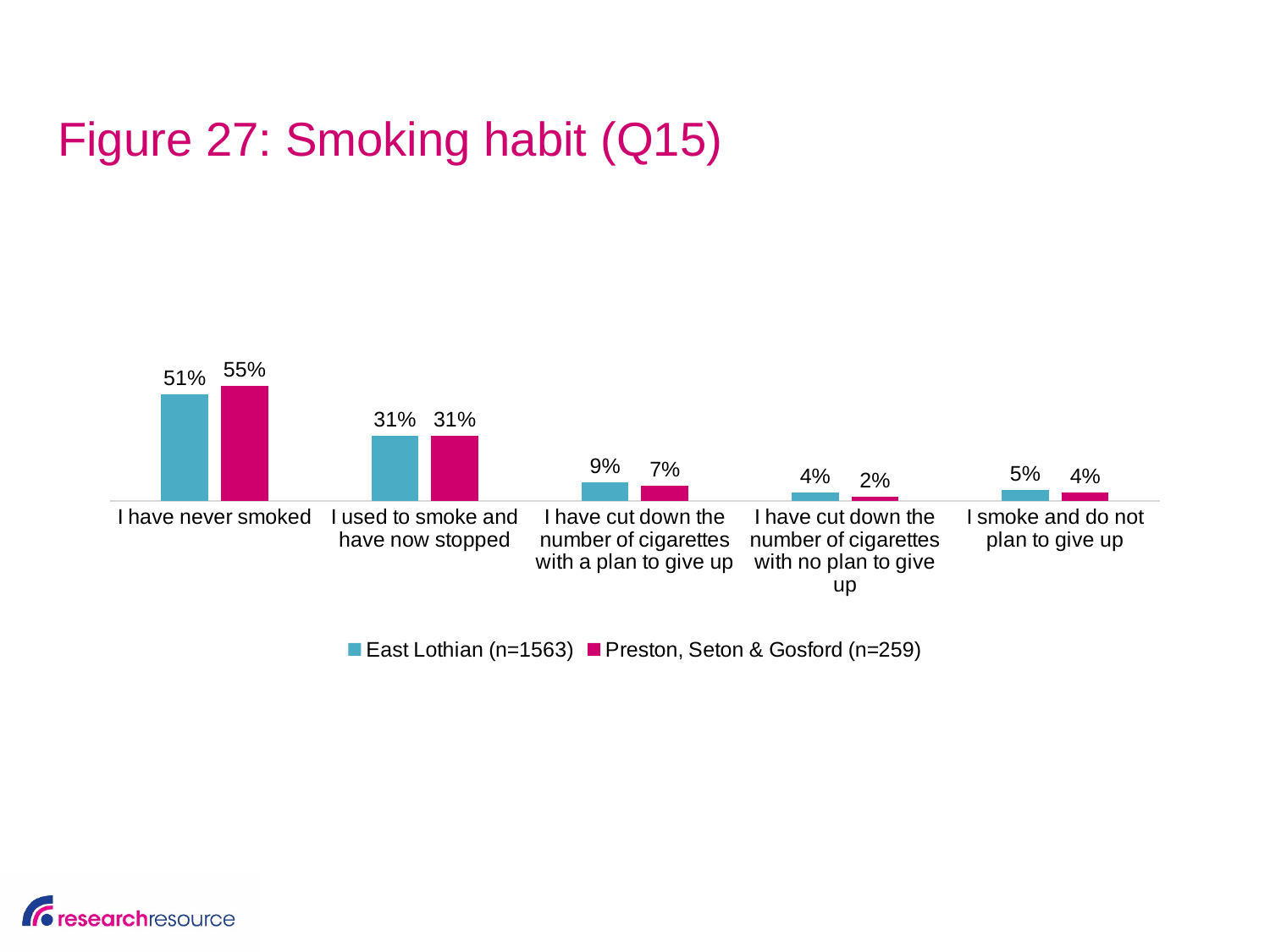
What kind of chart is shown on the slide? Bar chart What percentage of East Lothian respondents said 'I have never smoked'? 51% How many categories are shown on the x axis? 5 What is the value for East Lothian for 'I smoke and do not plan to give up'? 5% Which category has the lowest value for Preston, Seton & Gosford? I have cut down the number of cigarettes with no plan to give up How many series does the legend list? 2 Which category has the highest value for East Lothian? I have never smoked What is the sample size (n) for the Preston, Seton & Gosford series shown in the legend? 259 What is the value for Preston, Seton & Gosford for 'I have cut down the number of cigarettes with no plan to give up'? 2% What percentage of Preston, Seton & Gosford respondents said 'I have never smoked'? 55% For 'I have cut down the number of cigarettes with a plan to give up', which series has the larger value? East Lothian (n=1563) What is the difference between the Preston, Seton & Gosford and East Lothian values for 'I have never smoked'? 4%